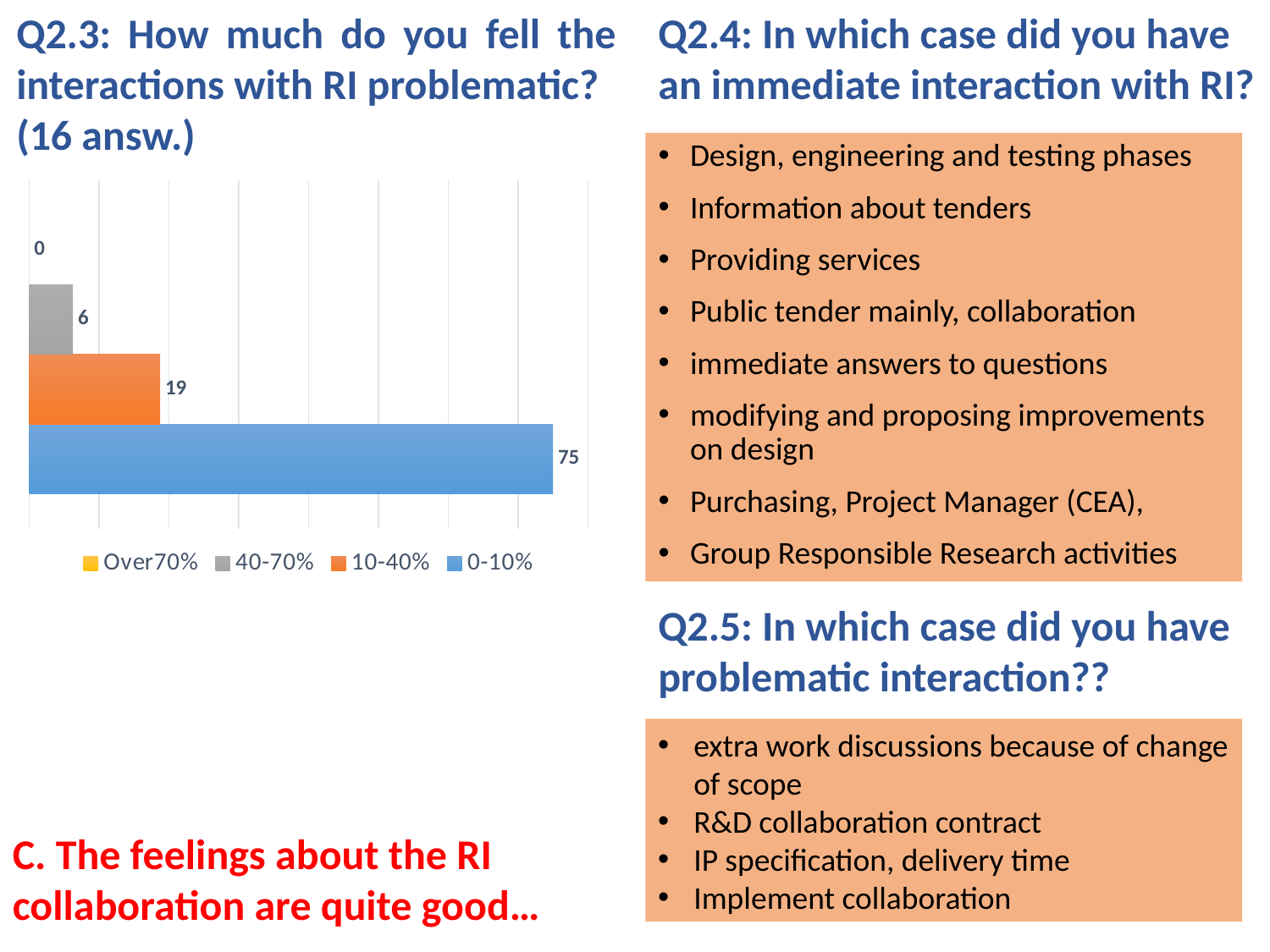
What colour is the bar for the 0-10% series? Blue Which series has the lowest value? Over70% Which is larger, the value for 40-70% or the value for 10-40%? 10-40% What kind of chart is shown on the slide? Bar chart What is the difference between the values for 10-40% and 40-70%? 13 What value is shown for the Over70% series? 0 What value is shown for the 10-40% series? 19 Which series has the highest value? 0-10% What is the difference between the values for 0-10% and 10-40%? 56 What value is shown for the 40-70% series? 6 How many series does the legend list? 4 What value is shown for the 0-10% series? 75